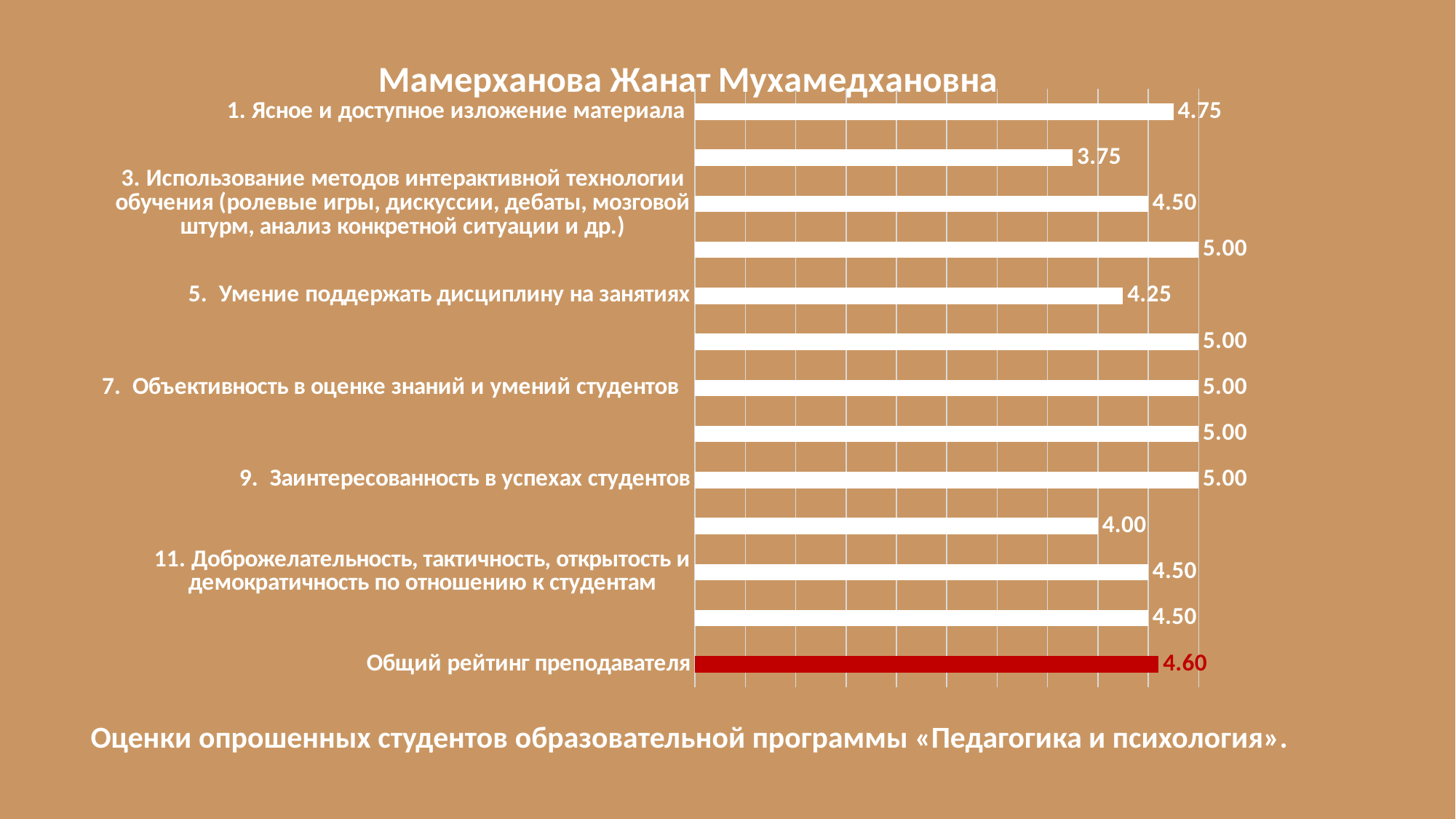
What is the lowest value shown on any bar in the chart? 3.75 What is the value for "9. Заинтересованность в успехах студентов"? 5.00 Which has the larger value: "1. Ясное и доступное изложение материала" or "11. Доброжелательность, тактичность, открытость и демократичность по отношению к студентам"? 1. Ясное и доступное изложение материала What is the value for "11. Доброжелательность, тактичность, открытость и демократичность по отношению к студентам"? 4.50 What kind of chart is shown on the slide? Bar chart What is the title of the chart? Мамерханова Жанат Мухамедхановна What is the difference between the value for "1. Ясное и доступное изложение материала" and the value for "5. Умение поддержать дисциплину на занятиях"? 0.50 What is the value for "7. Объективность в оценке знаний и умений студентов"? 5.00 What is the value for "1. Ясное и доступное изложение материала"? 4.75 How many bars are plotted in the chart? 13 What is the value for "Общий рейтинг преподавателя"? 4.60 What is the value for "5. Умение поддержать дисциплину на занятиях"? 4.25